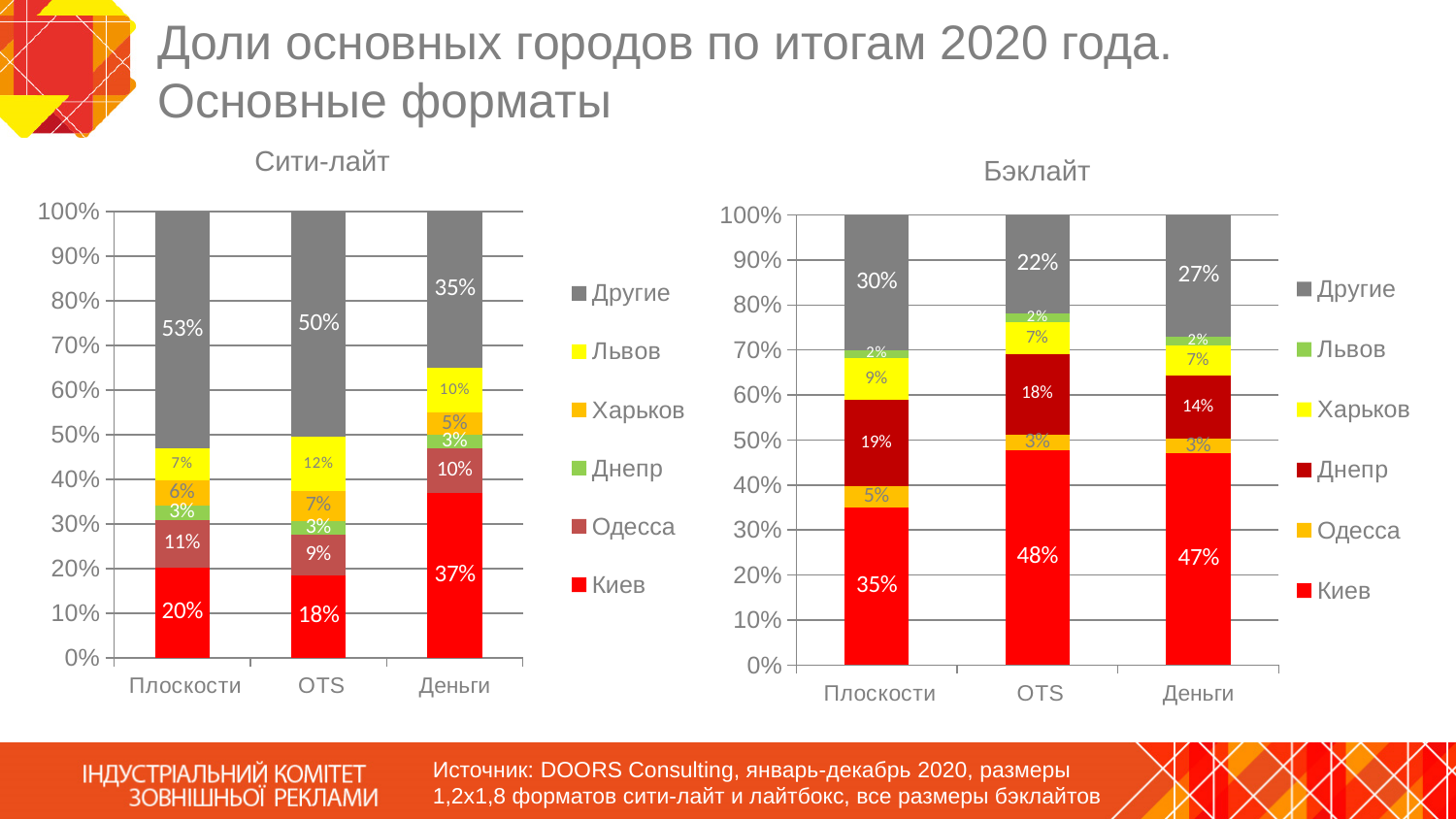
In the Сити-лайт chart, what is the value for Другие in the OTS bar? 50% How many series does the legend of the Сити-лайт chart list? 6 In the Сити-лайт chart, which category has the highest value for Киев? Деньги In the Сити-лайт chart, what is the difference between the Другие values for Плоскости and Деньги? 18% In the Сити-лайт chart, what is the value for Киев in the Деньги bar? 37% How many categories are shown on the x axis of the Бэклайт chart? 3 What kind of chart is the Бэклайт chart? Stacked bar chart In the Бэклайт chart, which is larger: Киев for Плоскости or Киев for Деньги? Киев for Деньги In the Бэклайт chart, what is the value for Днепр in the Плоскости bar? 19% In the Сити-лайт chart, what is the value for Львов in the OTS bar? 12% In the Бэклайт chart, what is the value for Киев in the OTS bar? 48% In the Бэклайт chart, which category has the lowest value for Другие? OTS